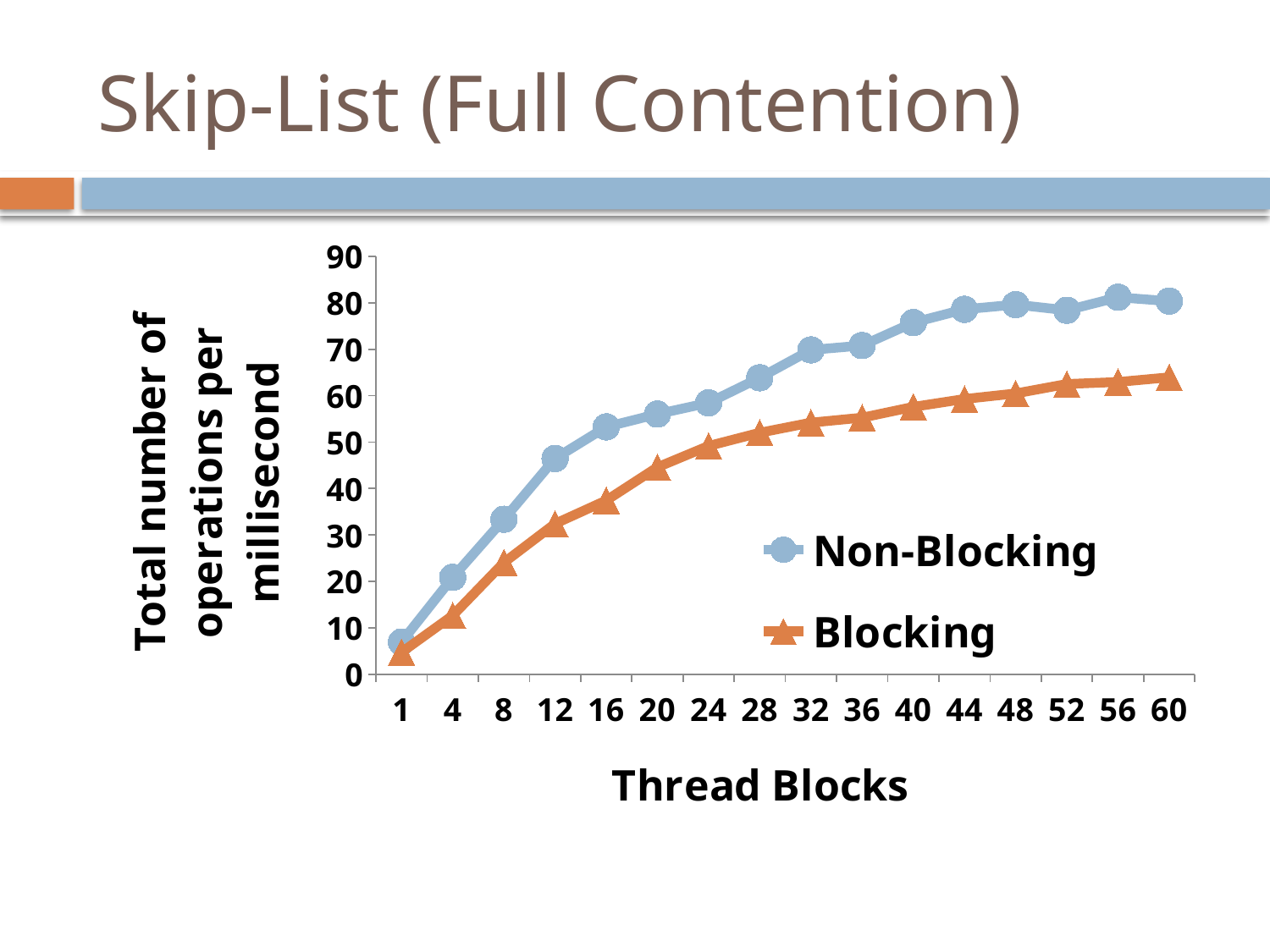
Which series has the higher value at 60 thread blocks, Non-Blocking or Blocking? Non-Blocking Do the Non-Blocking values rise or fall as the number of thread blocks increases? rise Which series is drawn with triangle markers? Blocking Which series has the higher value at 20 thread blocks, Non-Blocking or Blocking? Non-Blocking Is the Blocking value at 1 thread block greater or less than 10? less Is the Blocking value at 60 thread blocks greater or less than 50? greater What kind of chart is shown on the slide? line chart How many thread block values are plotted along the x axis? 16 Is the Non-Blocking value at 60 thread blocks greater or less than 70? greater What is the title of the x axis? Thread Blocks How many series does the legend list? 2